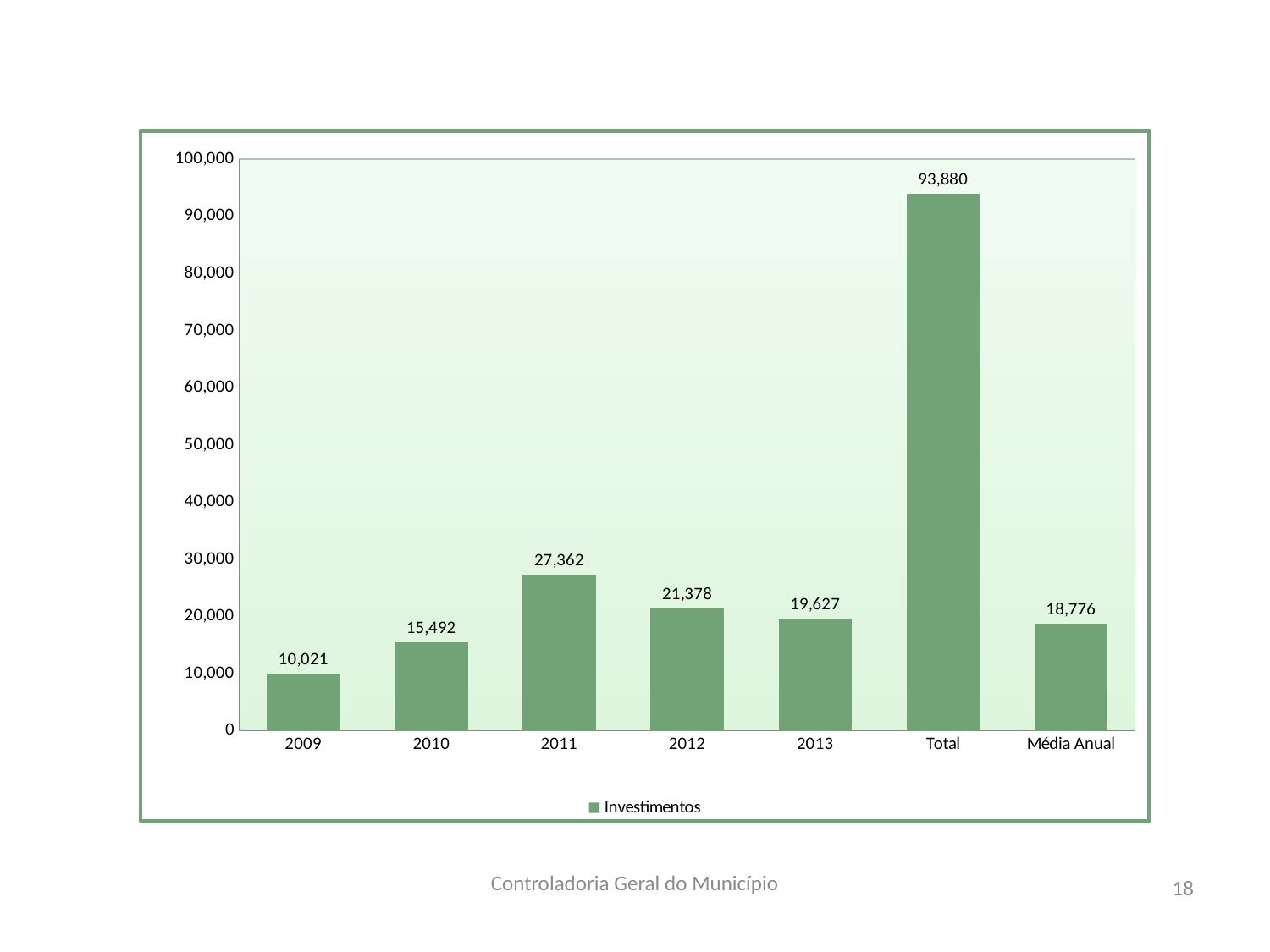
What is the value for 2011? 27,362 What is the difference between the values for 2012 and 2013? 1,751 What kind of chart is shown? bar chart Which is larger, the value for 2010 or the value for 2013? 2013 What is the value for Média Anual? 18,776 What is the value for 2009? 10,021 How many series does the legend list? 1 Which year from 2009 to 2013 has the highest value? 2011 How many categories are shown on the x axis? 7 Is the value for Total greater or less than 90,000? greater What is the name of the series in the legend? Investimentos Which category has the lowest value? 2009